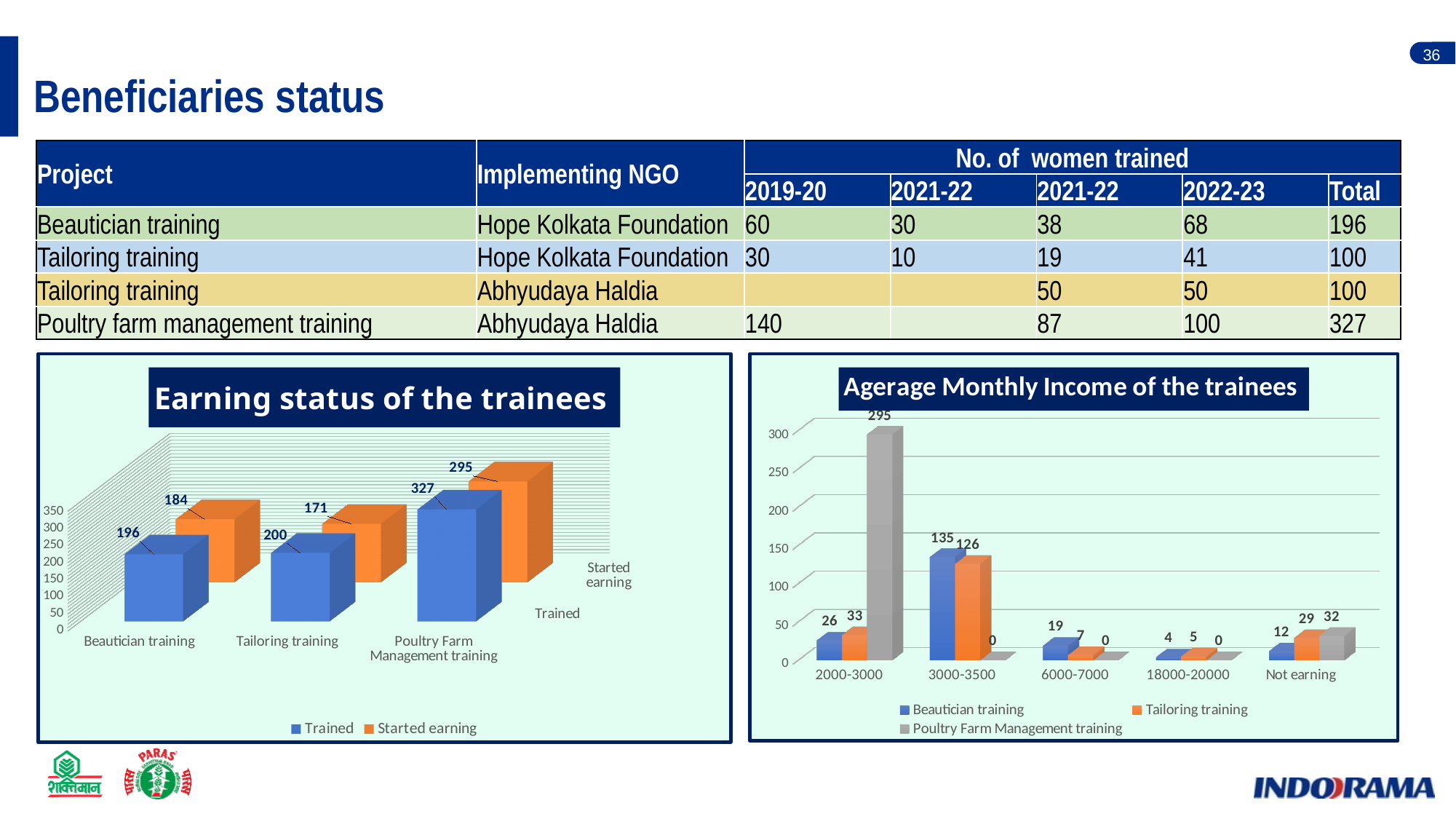
In the 'Agerage Monthly Income of the trainees' chart, what is the value for Poultry Farm Management training in the 2000-3000 category? 295 In the 'Agerage Monthly Income of the trainees' chart, which series has the lowest value in the Not earning category? Beautician training In the 'Agerage Monthly Income of the trainees' chart, how many categories are shown on the x axis? 5 In the 'Earning status of the trainees' chart, what is the Started earning value for Tailoring training? 171 In the 'Earning status of the trainees' chart, what is the Trained value for Poultry Farm Management training? 327 In the 'Earning status of the trainees' chart, how many series does the legend list? 2 What kind of chart is the 'Earning status of the trainees' chart? Bar chart In the 'Agerage Monthly Income of the trainees' chart, how many series does the legend list? 3 In the 'Earning status of the trainees' chart, which category has the highest Trained value? Poultry Farm Management training In the 'Earning status of the trainees' chart, what is the difference between Trained and Started earning for Beautician training? 12 In the 'Agerage Monthly Income of the trainees' chart, is the value for Tailoring training in the 6000-7000 category larger or smaller than the value for Beautician training in that category? Smaller In the 'Agerage Monthly Income of the trainees' chart, what is the value for Beautician training in the 3000-3500 category? 135